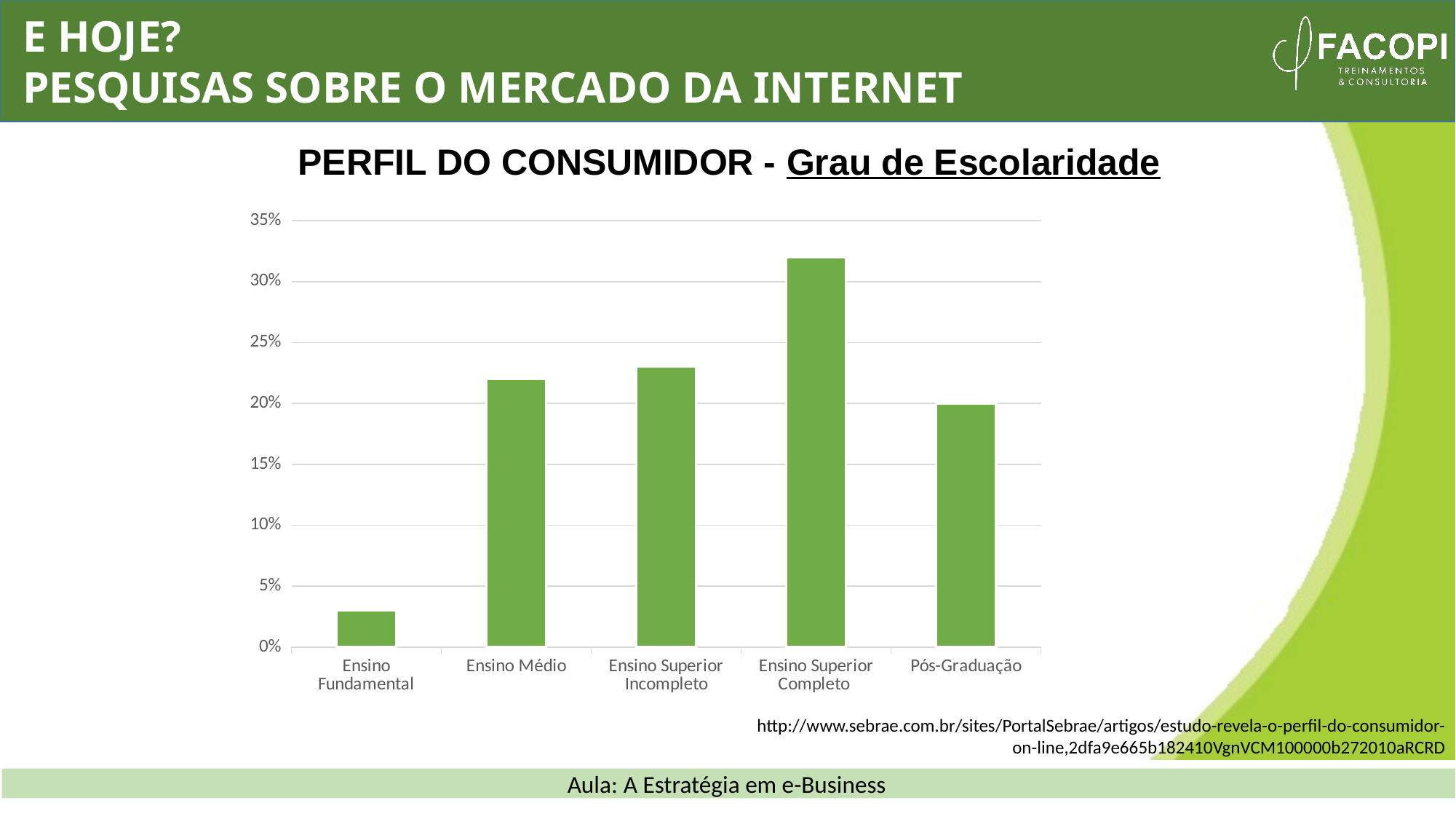
Is the value for Ensino Superior Completo greater or less than 30%? greater How many education-level categories are shown on the x axis of the chart? 5 Which category has the highest bar in the chart? Ensino Superior Completo Which is larger, the value for Ensino Superior Completo or the value for Pós-Graduação? Ensino Superior Completo Is the value for Ensino Médio greater or less than 20%? greater What is the title of the chart on the slide? PERFIL DO CONSUMIDOR - Grau de Escolaridade Is the value for Ensino Fundamental greater or less than 5%? less Which is larger, the value for Ensino Fundamental or the value for Ensino Médio? Ensino Médio What kind of chart is shown on the slide? bar chart Which category has the lowest bar in the chart? Ensino Fundamental